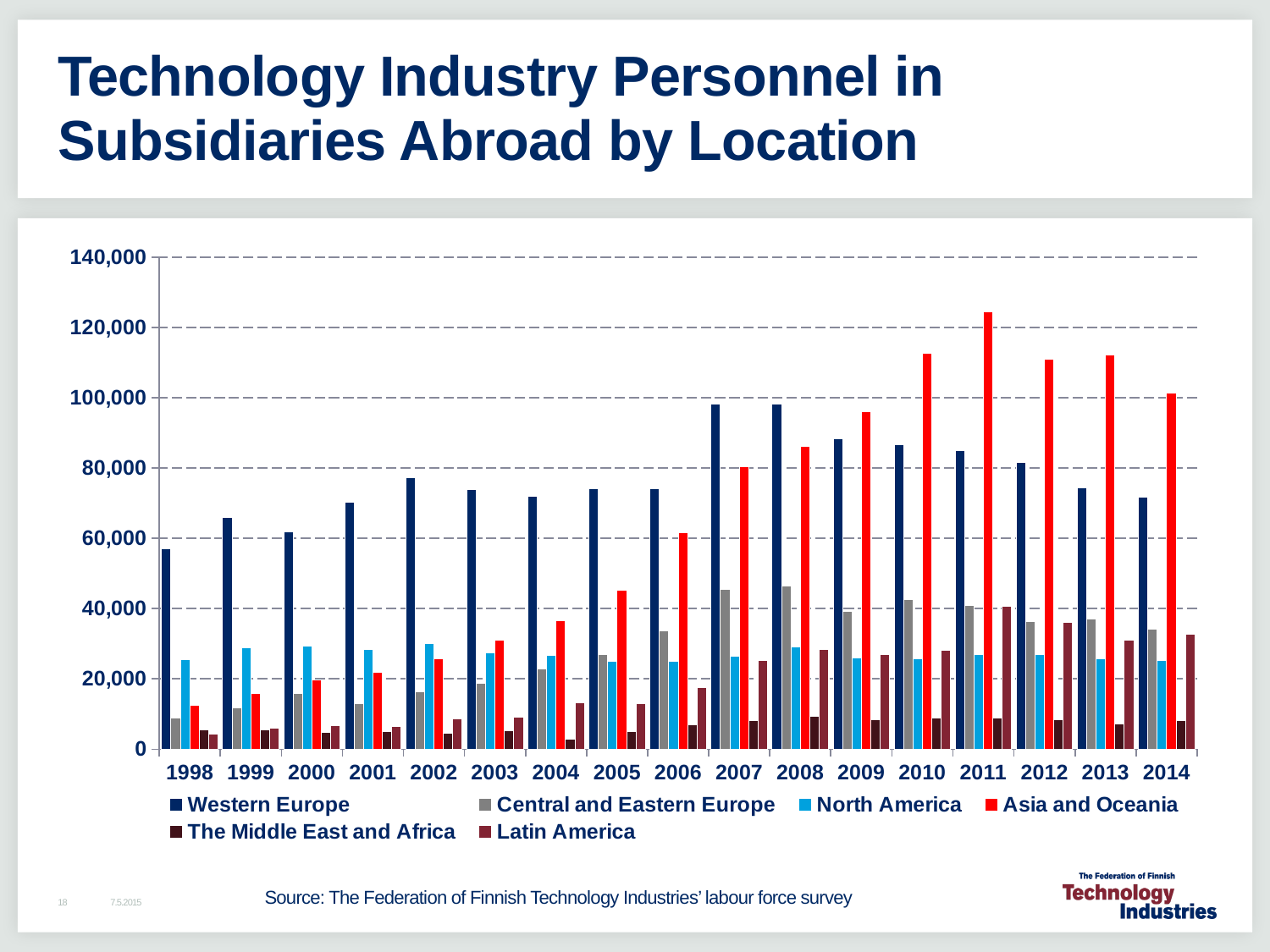
What kind of chart is shown on the slide? Bar chart How many years are shown on the x axis? 17 How many series does the legend list? 6 Is the value for Western Europe in 2014 greater or less than 60,000? greater What colour represents Asia and Oceania in the legend? Red In 1998, which is larger: Western Europe or Asia and Oceania? Western Europe Does the Asia and Oceania series rise or fall from 1998 to 2011? rise Is the value for Asia and Oceania in 2011 greater or less than 120,000? greater In 2014, which is larger: Western Europe or Asia and Oceania? Asia and Oceania In which year is the Asia and Oceania value highest? 2011 Is the value for Western Europe in 2007 greater or less than 100,000? less